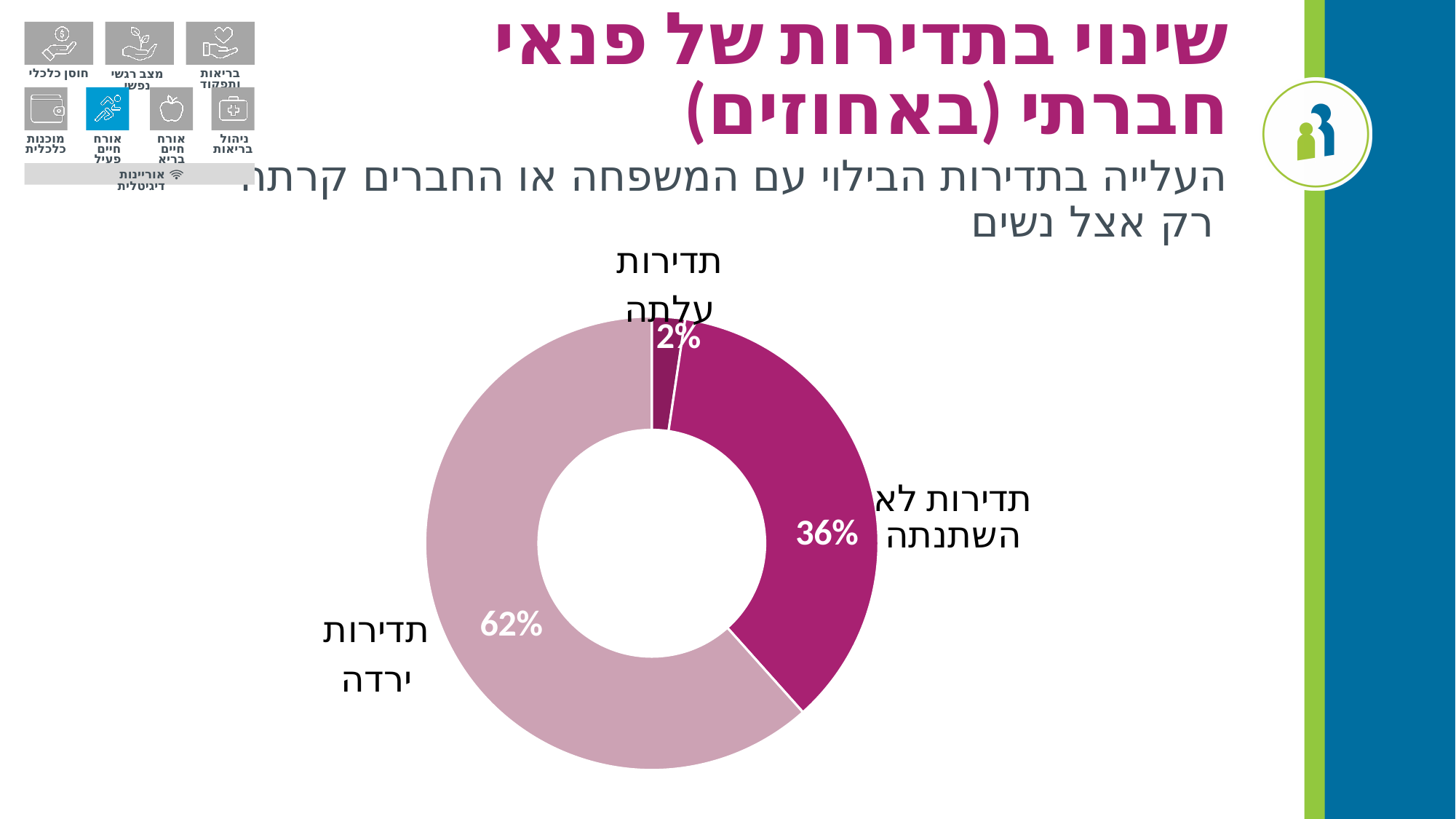
How many categories (slices) does the chart show? 3 What is the difference in percentage points between "תדירות ירדה" and "תדירות לא השתנתה"? 26 What is the combined share of "תדירות ירדה" and "תדירות לא השתנתה"? 98% What percentage is shown for the slice labelled "תדירות ירדה" (frequency decreased)? 62% What is the difference in percentage points between "תדירות לא השתנתה" and "תדירות עלתה"? 34 What percentage is shown for the slice labelled "תדירות לא השתנתה" (frequency unchanged)? 36% What kind of chart is shown on the slide? Donut (pie) chart Which category has the smallest share of the chart? תדירות עלתה Which is larger: the share for "תדירות לא השתנתה" or the share for "תדירות עלתה"? תדירות לא השתנתה Which category has the largest share of the chart? תדירות ירדה What percentage is shown for the slice labelled "תדירות עלתה" (frequency increased)? 2% What is the title of the slide containing the chart? שינוי בתדירות של פנאי חברתי (באחוזים)